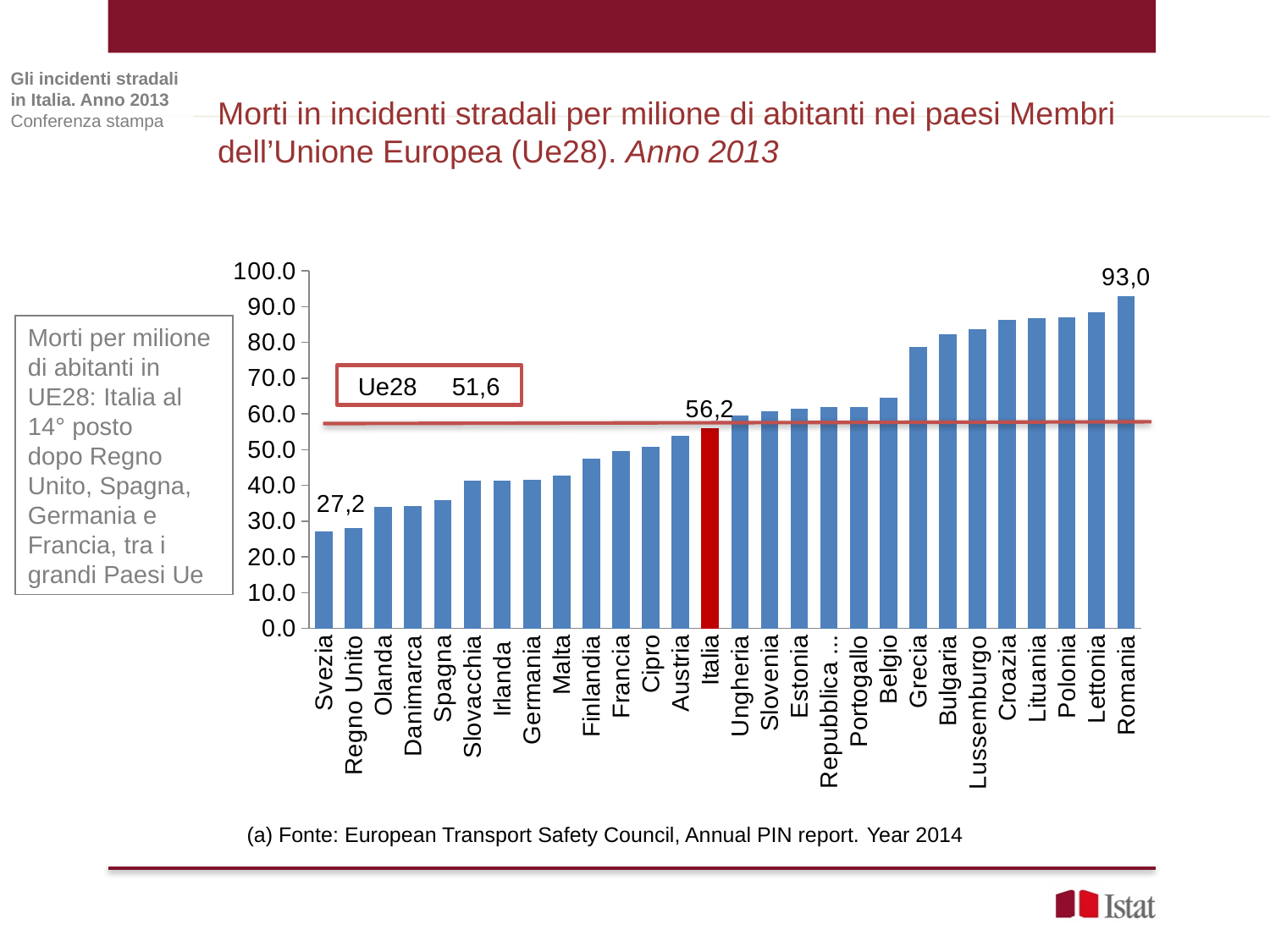
What colour is the bar for Italia? red Is the value for Grecia greater or less than 70? greater Which is larger, the value for Italia or the value for Svezia? Italia What is the value for Romania? 93,0 What is the value for Italia? 56,2 What is the Ue28 value shown in the box on the chart? 51,6 What is the value for Svezia? 27,2 What is the difference between the values for Romania and Svezia? 65,8 Which country has the lowest value? Svezia What kind of chart is this? bar chart Which country has the highest value? Romania How many countries are shown on the x axis? 28